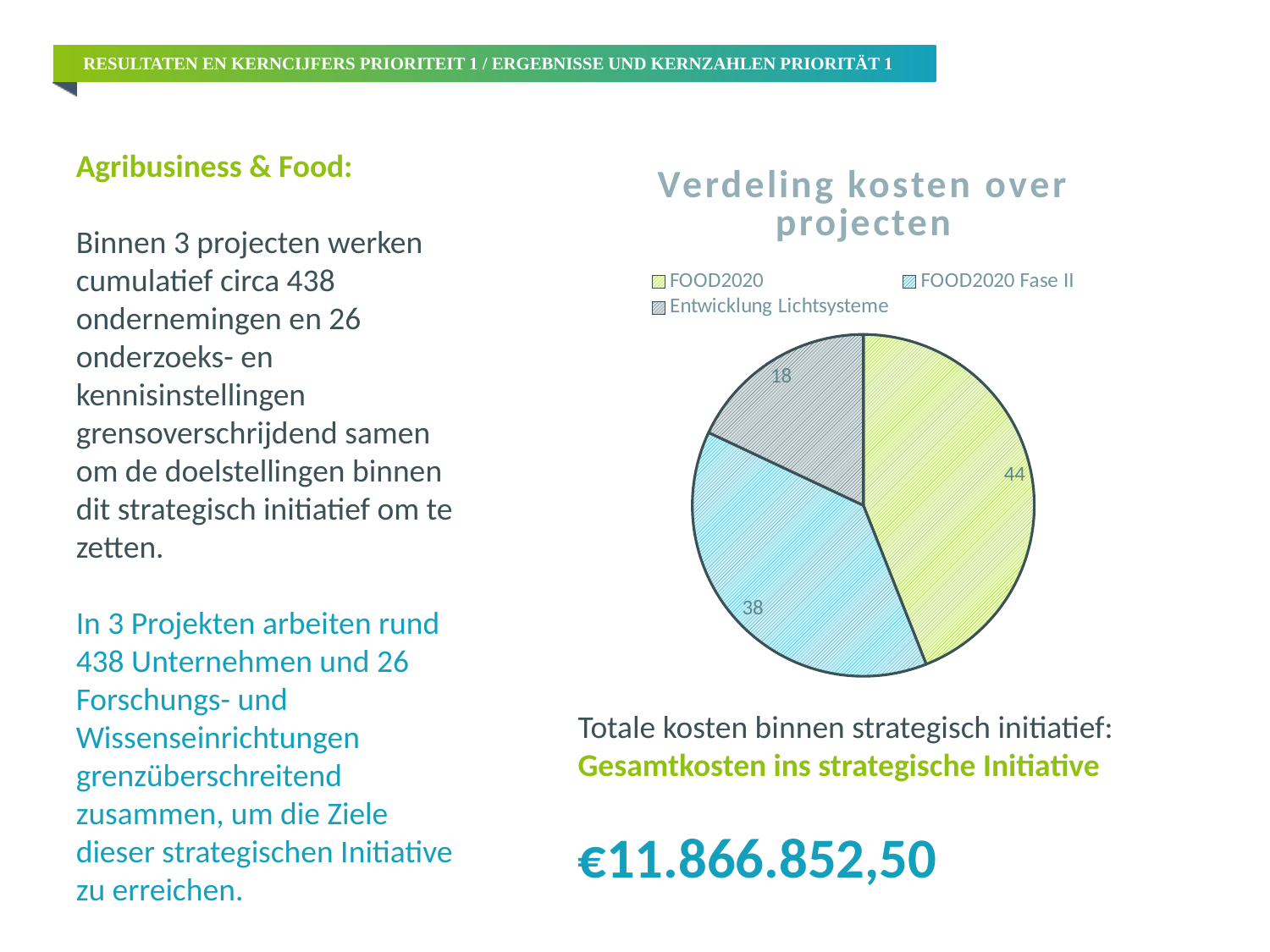
How many slices does the pie chart have? 3 Which project has the largest slice of the pie? FOOD2020 What is the value shown for FOOD2020? 44 How many series does the chart legend list? 3 Which project has the smallest slice of the pie? Entwicklung Lichtsysteme What is the value shown for Entwicklung Lichtsysteme? 18 What kind of chart is shown on the slide? pie chart What is the title of the chart? Verdeling kosten over projecten What is the difference between the values for FOOD2020 and FOOD2020 Fase II? 6 What is the value shown for FOOD2020 Fase II? 38 Which is larger, the value for FOOD2020 Fase II or the value for Entwicklung Lichtsysteme? FOOD2020 Fase II Which legend entry is shown in grey? Entwicklung Lichtsysteme